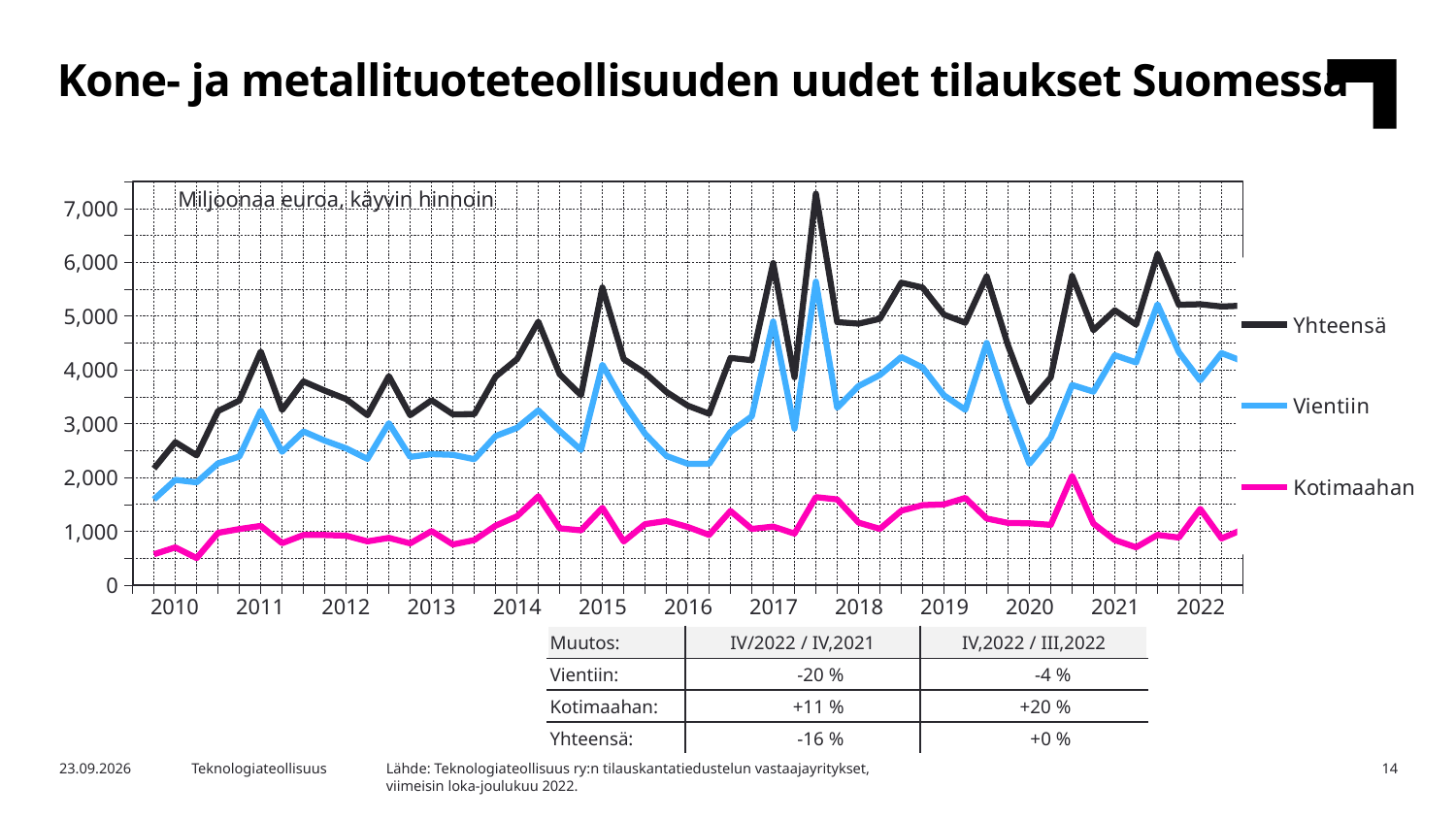
What are the three series named in the legend? Yhteensä, Vientiin, Kotimaahan Is the peak value of Yhteensä in 2017 greater or less than 7,000? greater Which series has the lowest values throughout the chart? Kotimaahan How many years are labelled on the x axis? 13 Does the Yhteensä series overall rise or fall from 2010 to 2022? rise What is the title of the chart on the slide? Kone- ja metallituoteteollisuuden uudet tilaukset Suomessa What kind of chart is shown on the slide? line chart Which series is larger in 2019, Vientiin or Kotimaahan? Vientiin Is the first value for Kotimaahan in 2010 greater or less than 1,000? less Is the first value for Vientiin in 2010 greater or less than 2,000? less How many series does the legend list? 3 Which series reaches the highest value on the chart? Yhteensä